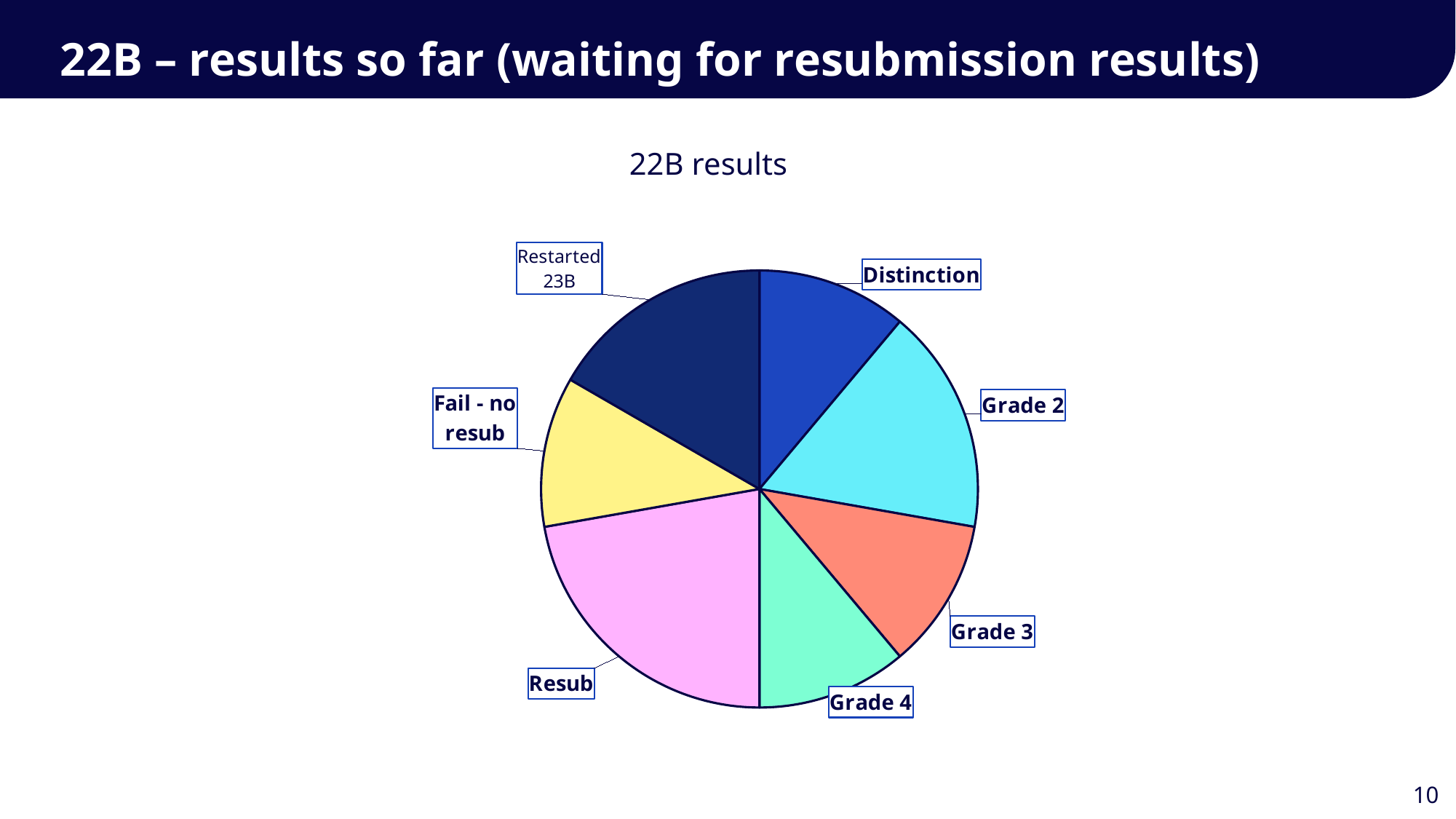
What is the title of the chart? 22B results Which slice is larger, Resub or Fail - no resub? Resub Which slice is larger, Restarted 23B or Grade 3? Restarted 23B Which slice is larger, Resub or Distinction? Resub What colour is the Resub slice? pink How many slices does the pie chart have? 7 Which category has the largest slice of the pie? Resub What kind of chart is shown on the slide? pie chart